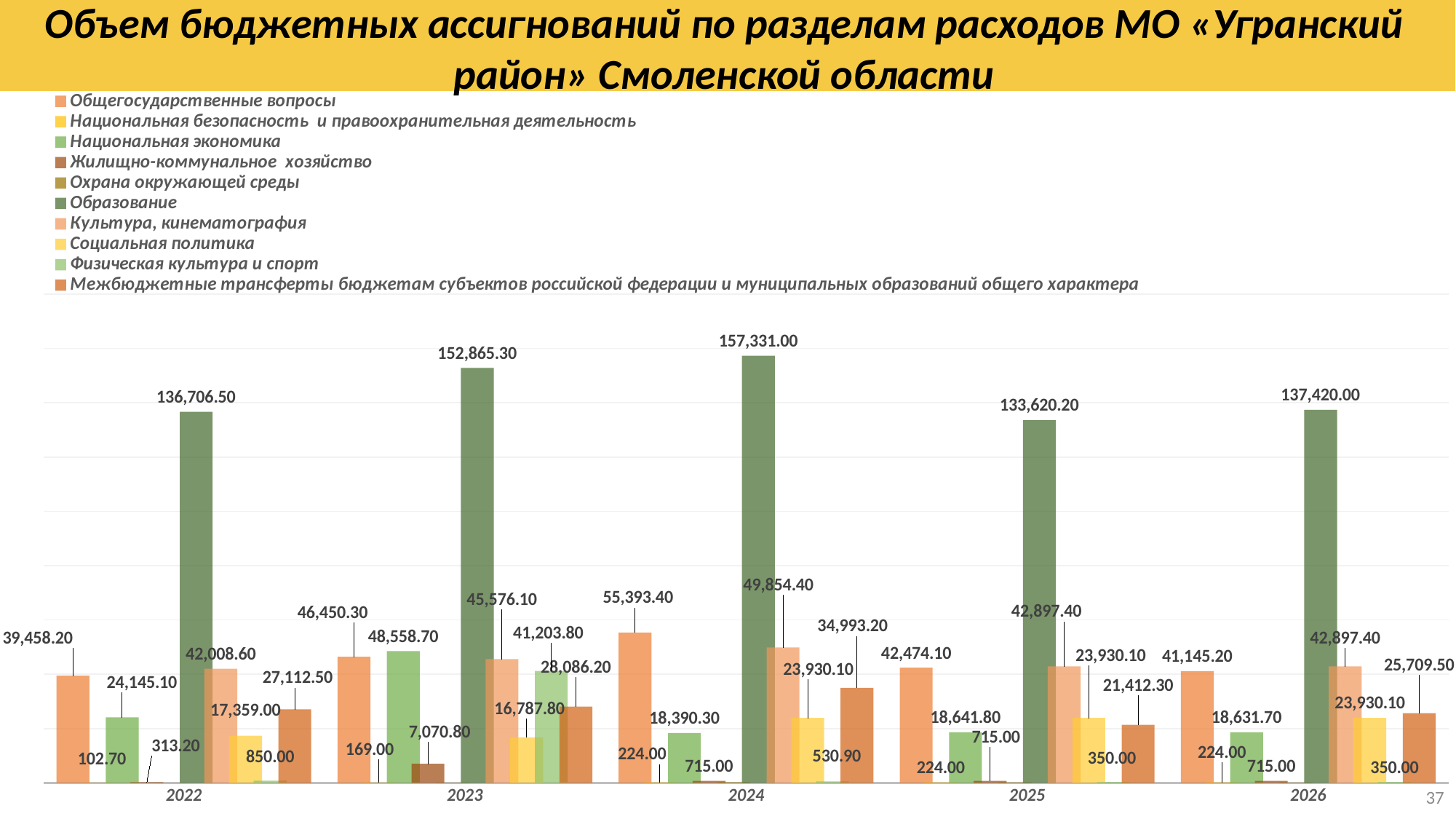
Does the value for Образование rise or fall from 2022 to 2024? Rises What is the difference between the Общегосударственные вопросы values for 2024 and 2025? 12,919.30 What is the value for Образование in 2022? 136,706.50 How many series does the legend list? 10 What is the value for Общегосударственные вопросы in 2024? 55,393.40 What kind of chart is shown on the slide? Bar chart In which year is the value for Образование the lowest? 2025 In which year is the value for Образование the highest? 2024 What is the value for Образование in 2024? 157,331.00 Which year has the larger value for Общегосударственные вопросы, 2022 or 2023? 2023 How many years (categories) are shown along the x axis? 5 What is the difference between the Образование values for 2024 and 2023? 4,465.70